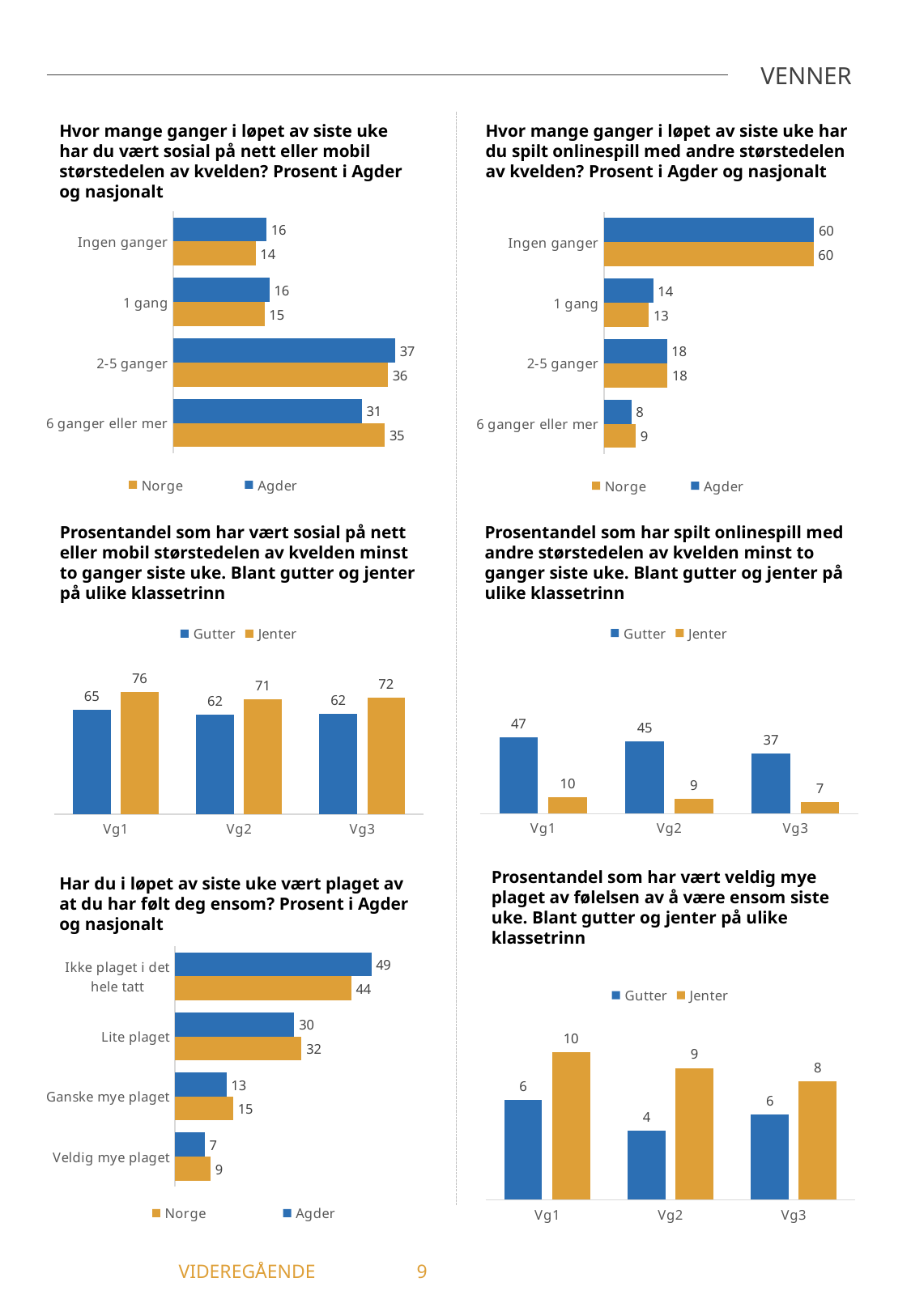
In the middle-left chart (sosial på nett minst to ganger, gutter og jenter), which is larger at Vg3: Gutter or Jenter? Jenter In the top-right chart (spilt onlinespill, Agder og nasjonalt), what is the value for Norge in the 'Ingen ganger' category? 60 In the top-left chart (sosial på nett eller mobil, Agder og nasjonalt), what is the difference between the Norge and Agder values for '6 ganger eller mer'? 4 In the bottom-left chart (plaget av å ha følt deg ensom, Agder og nasjonalt), what kind of chart is it? bar chart In the bottom-left chart (plaget av å ha følt deg ensom, Agder og nasjonalt), what is the value for Norge in the 'Lite plaget' category? 32 In the middle-left chart (sosial på nett minst to ganger, gutter og jenter), what is the value for Jenter at Vg1? 76 In the top-right chart (spilt onlinespill, Agder og nasjonalt), how many categories are shown? 4 In the top-left chart (sosial på nett eller mobil, Agder og nasjonalt), what is the value for Agder in the '2-5 ganger' category? 37 In the top-right chart (spilt onlinespill, Agder og nasjonalt), which category has the lowest value for Agder? 6 ganger eller mer In the middle-right chart (spilt onlinespill minst to ganger, gutter og jenter), do the Gutter values rise or fall from Vg1 to Vg3? fall In the middle-right chart (spilt onlinespill minst to ganger, gutter og jenter), what is the difference between Gutter and Jenter at Vg1? 37 In the bottom-right chart (veldig mye plaget av ensomhet, gutter og jenter), which class level has the highest value for Jenter? Vg1